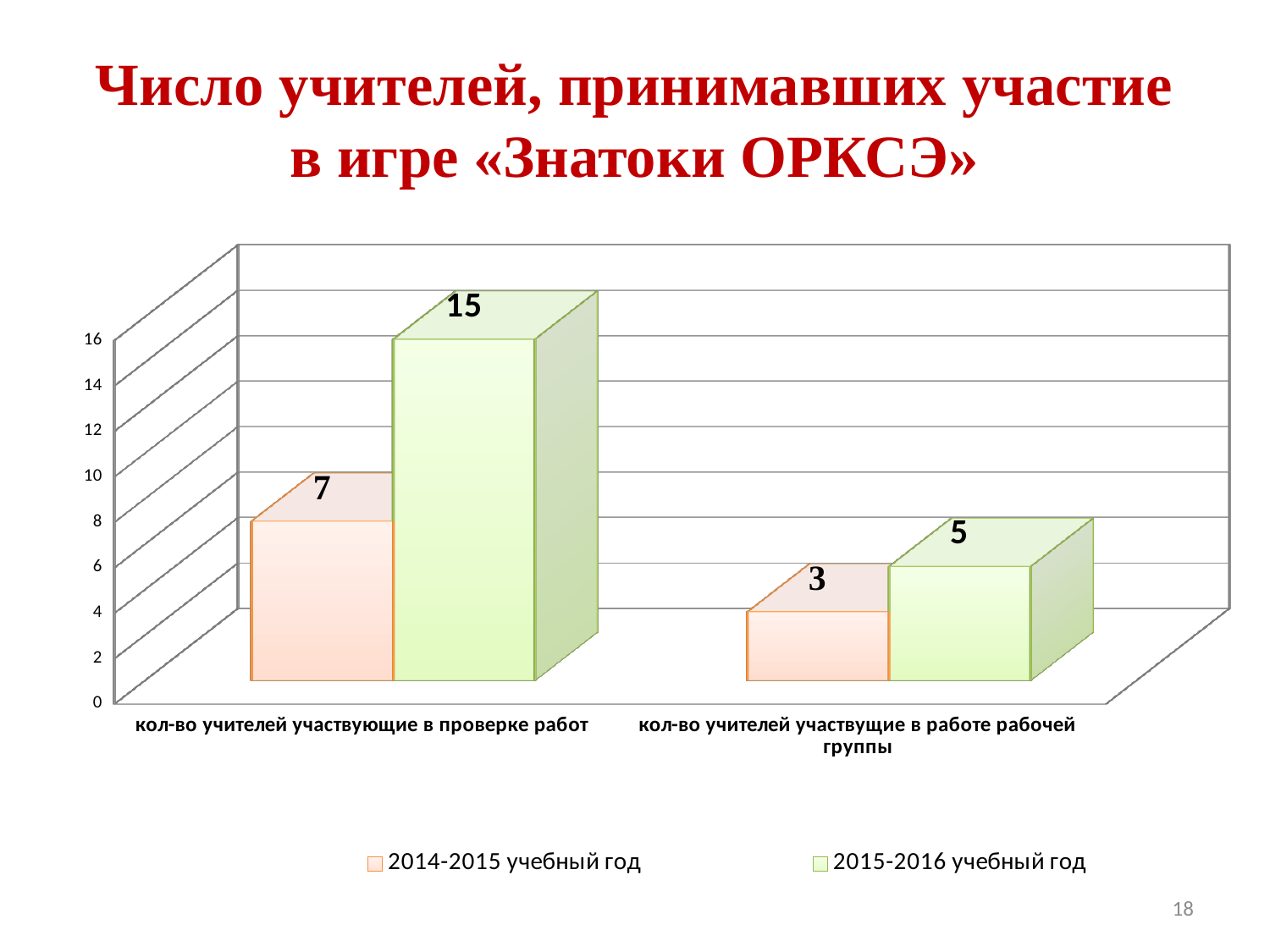
How many categories are shown on the x axis? 2 What is the value for 2014-2015 учебный год in the category 'кол-во учителей участвущие в работе рабочей группы'? 3 Which bar has the lowest value on the chart? 2014-2015 учебный год, кол-во учителей участвущие в работе рабочей группы What is the difference between the 2015-2016 and 2014-2015 values for 'кол-во учителей участвующие в проверке работ'? 8 What is the value for 2014-2015 учебный год in the category 'кол-во учителей участвующие в проверке работ'? 7 What kind of chart is shown on the slide? Bar chart What is the value for 2015-2016 учебный год in the category 'кол-во учителей участвущие в работе рабочей группы'? 5 Which is larger: the 2014-2015 value for 'кол-во учителей участвующие в проверке работ' or the 2015-2016 value for 'кол-во учителей участвущие в работе рабочей группы'? 2014-2015 value for кол-во учителей участвующие в проверке работ How many series does the legend list? 2 What is the difference between the 2015-2016 and 2014-2015 values for 'кол-во учителей участвущие в работе рабочей группы'? 2 What is the value for 2015-2016 учебный год in the category 'кол-во учителей участвующие в проверке работ'? 15 Which bar has the highest value on the chart? 2015-2016 учебный год, кол-во учителей участвующие в проверке работ